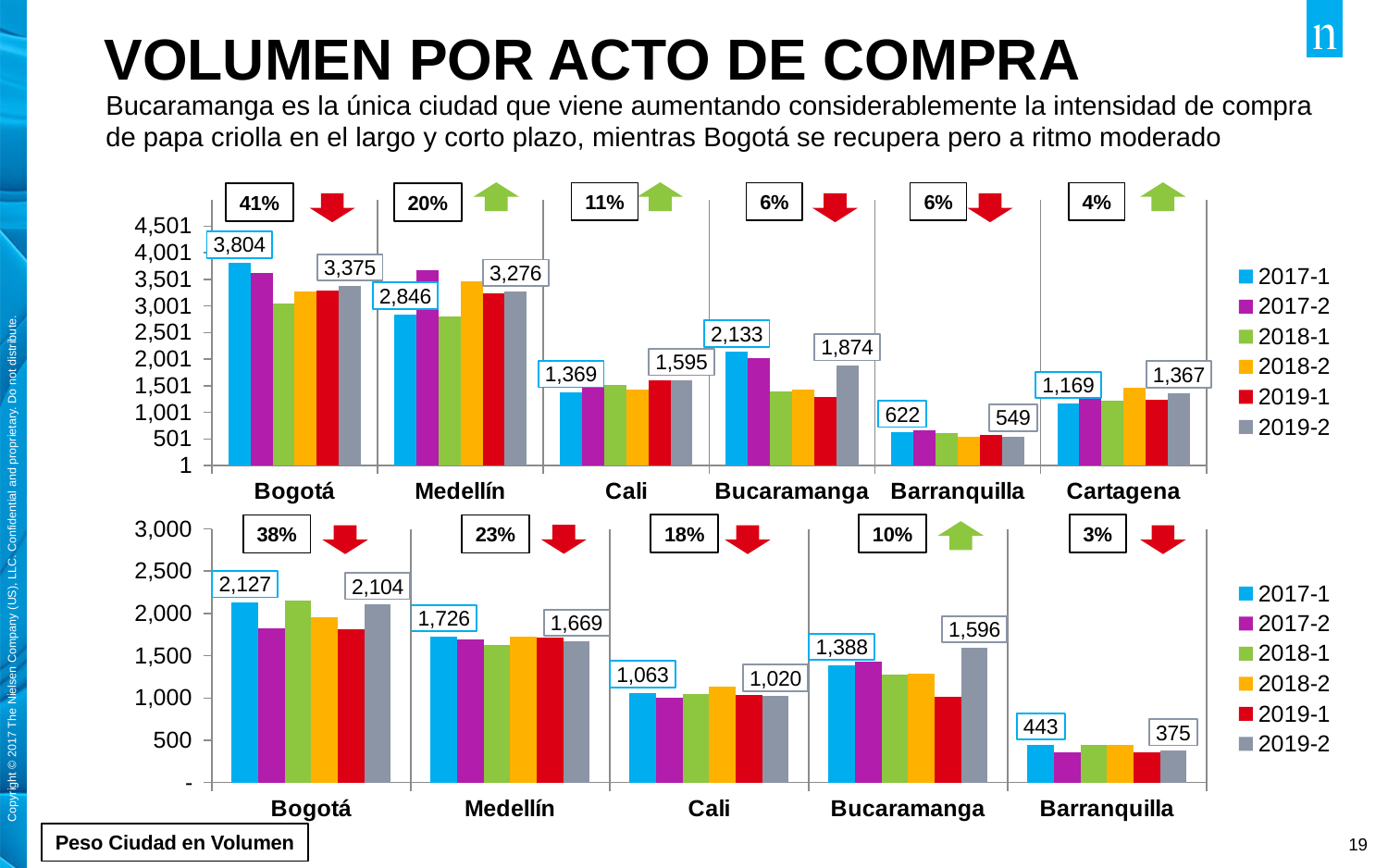
How many series does the legend of the top chart list? 6 In the bottom chart, what is the 2019-2 value for Bucaramanga? 1,596 In the top chart, what is the 2017-1 value for Bogotá? 3,804 In the bottom chart, which city has the highest 2019-2 value? Bogotá In the top chart, what is the difference between the 2017-1 and 2019-2 values for Bucaramanga? 259 In the top chart, what is the 2019-2 value for Medellín? 3,276 What kind of chart is the top chart? Bar chart How many cities are shown on the x axis of the bottom chart? 5 In the bottom chart, which is larger for Cali: the 2017-1 value or the 2019-2 value? 2017-1 In the bottom chart, what is the 2017-1 value for Barranquilla? 443 In the top chart, which city has the lowest 2017-1 value? Barranquilla In the top chart, is the 2018-1 value for Bogotá greater or less than 2,501? greater